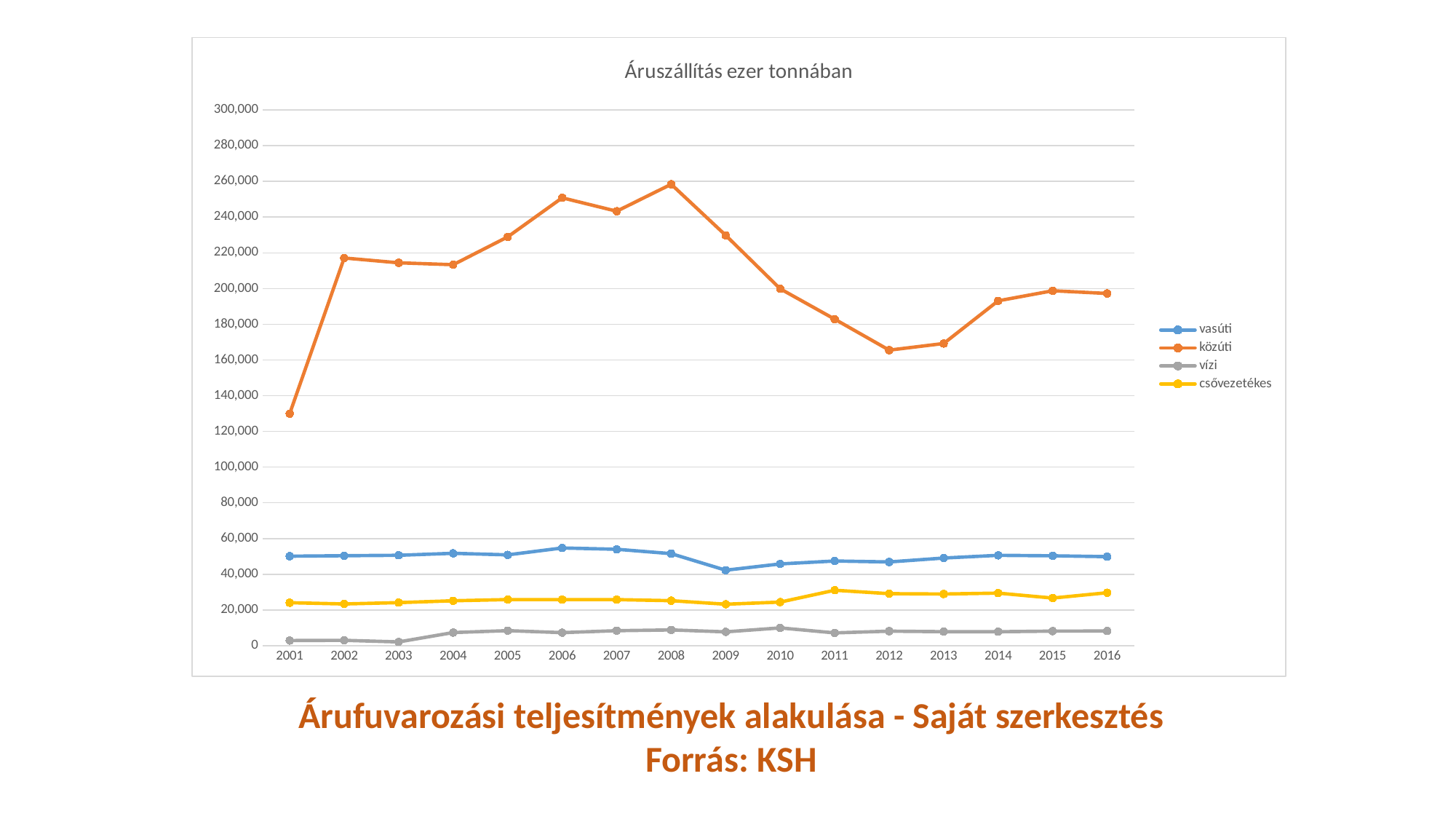
In which year does the közúti series have its lowest value? 2001 Does the közúti series rise or fall from 2008 to 2012? fall In which year does the közúti series reach its highest value? 2008 Is the közúti value for 2012 greater or less than 180,000? less Is the közúti value for 2008 greater or less than 240,000? greater Which series has the highest values throughout the chart? közúti How many years are plotted along the x axis? 16 What is the title of the chart? Áruszállítás ezer tonnában How many series does the legend list? 4 Is the közúti value for 2001 greater or less than 140,000? less Which is larger in 2016, the vasúti value or the csővezetékes value? vasúti What kind of chart is shown on the slide? line chart